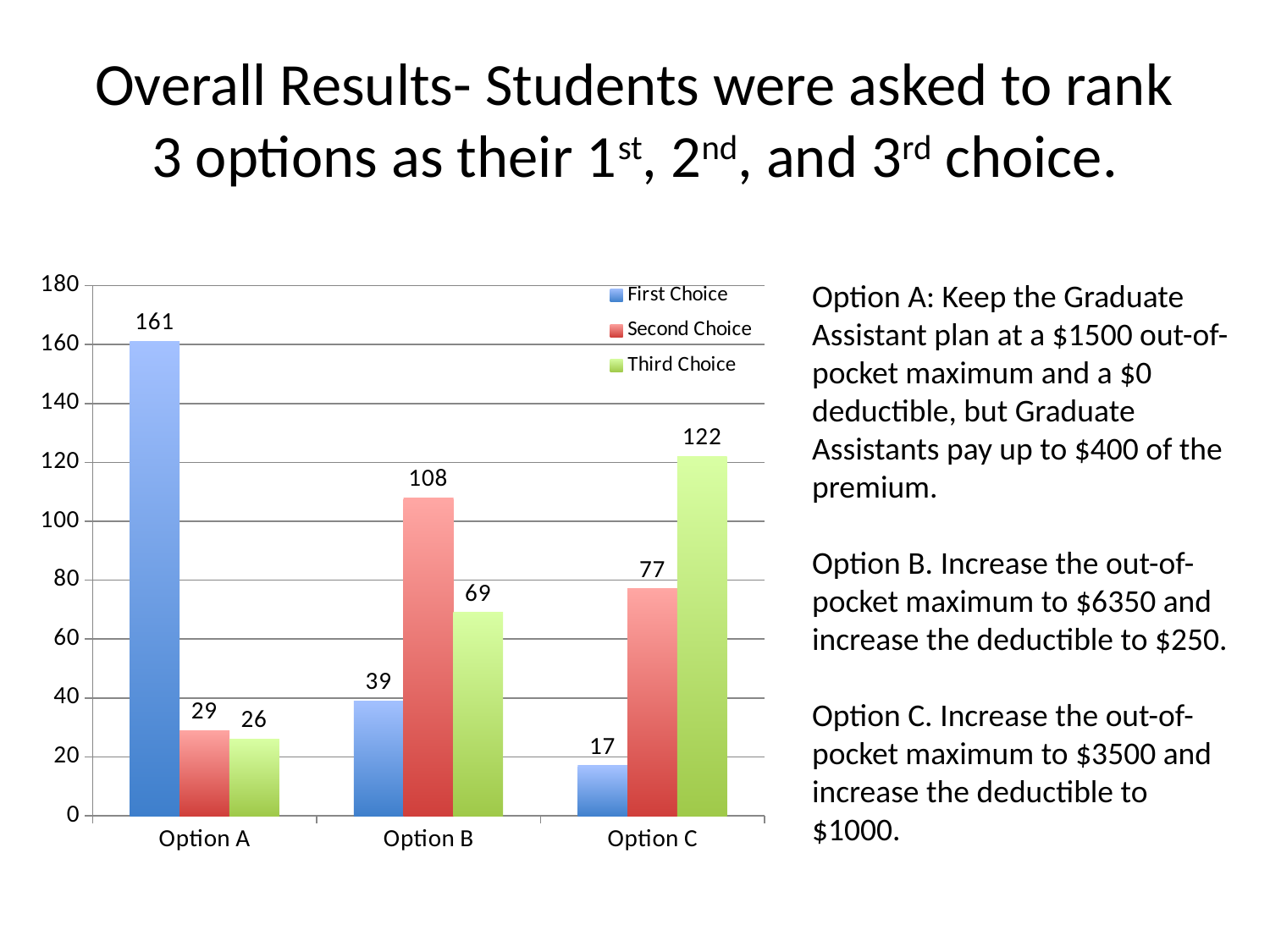
Which colour represents Third Choice in the legend? green How many series does the legend list? 3 How many options are shown on the x axis? 3 Which option has the highest First Choice value? Option A Is the First Choice value for Option B greater or less than 40? less What is the difference between the Second Choice and Third Choice values for Option B? 39 Which option has the lowest Third Choice value? Option A Which is larger: the Second Choice value for Option C or the Third Choice value for Option B? Second Choice value for Option C What is the First Choice value for Option A? 161 What is the Second Choice value for Option B? 108 What is the Third Choice value for Option C? 122 What kind of chart is shown on the slide? bar chart